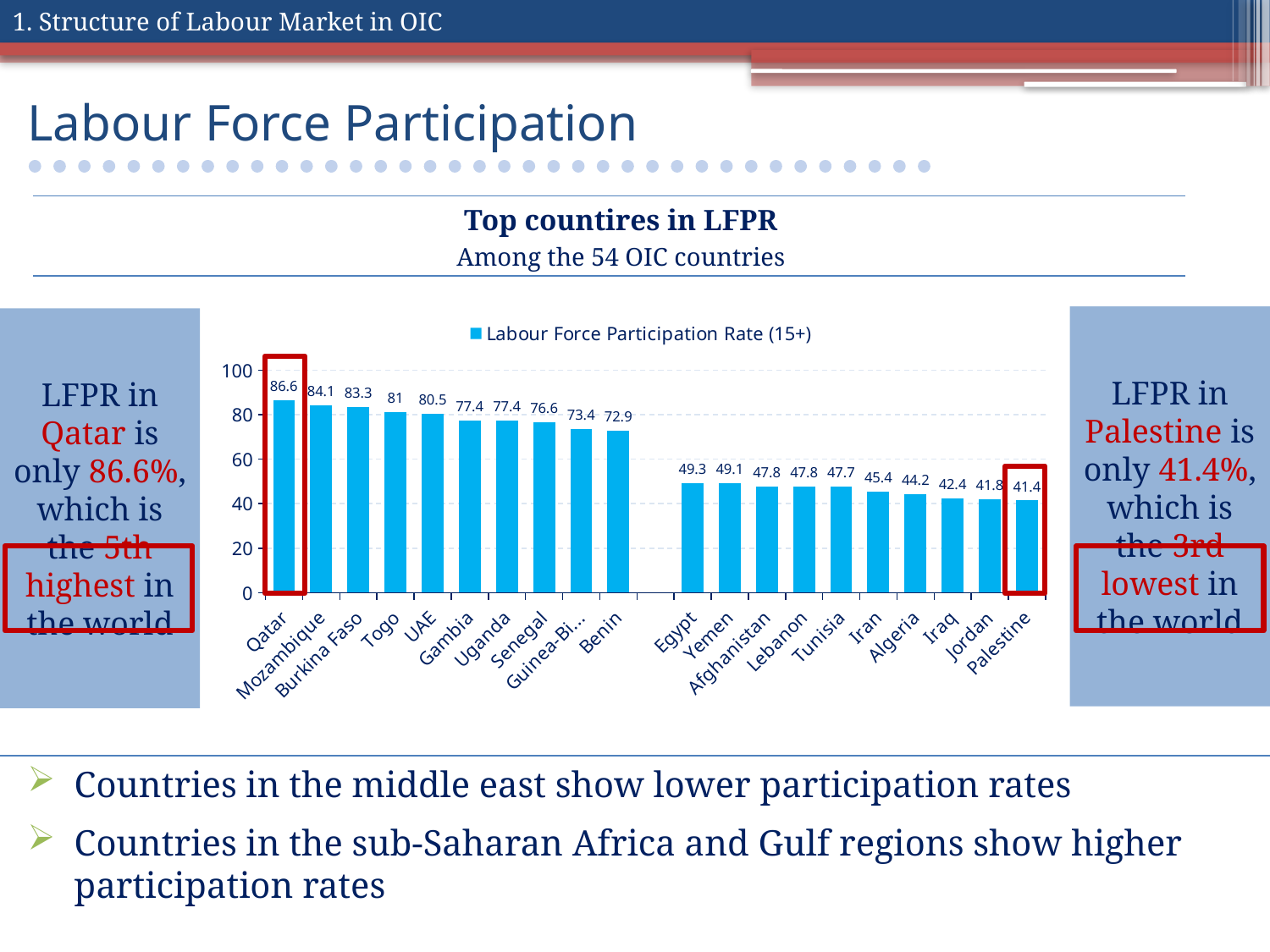
Which country has the highest Labour Force Participation Rate on the chart? Qatar What is the Labour Force Participation Rate for Palestine? 41.4 What is the difference between the Labour Force Participation Rate of Qatar and that of Palestine? 45.2 How many series does the legend list? 1 What is the Labour Force Participation Rate for Qatar? 86.6 What is the Labour Force Participation Rate for Togo? 81 What is the Labour Force Participation Rate for Egypt? 49.3 How many countries are shown on the chart? 20 What kind of chart is shown on the slide? Bar chart What is the legend entry of the chart? Labour Force Participation Rate (15+) Which has a higher Labour Force Participation Rate, UAE or Iran? UAE Which country has the lowest Labour Force Participation Rate on the chart? Palestine